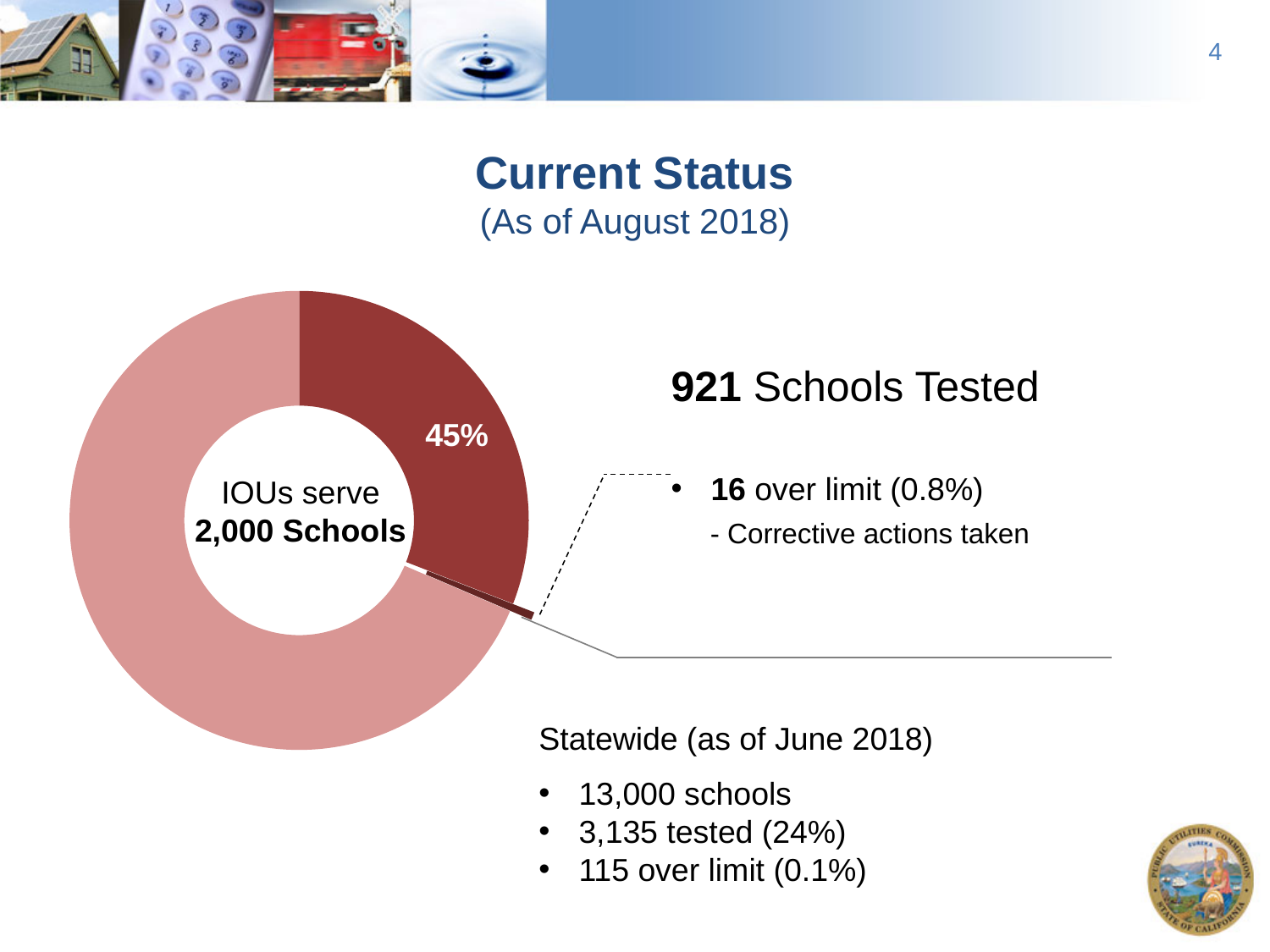
How many schools have been tested, according to the annotation next to the chart? 921 What kind of chart is shown on the slide? Pie chart (donut) Which slice of the donut chart is larger, the dark red slice or the light pink slice? The light pink slice How many schools were found over the limit, according to the chart annotation? 16 How many schools do the IOUs serve, according to the centre of the donut chart? 2,000 Schools What is the title of the slide containing the chart? Current Status (As of August 2018) What percentage is labelled on the dark red slice of the donut chart? 45% What percentage of schools were over the limit, as shown in the chart annotation? 0.8% Is the share of the dark red slice greater or less than 50%? less What text is written in the centre of the donut chart? IOUs serve 2,000 Schools